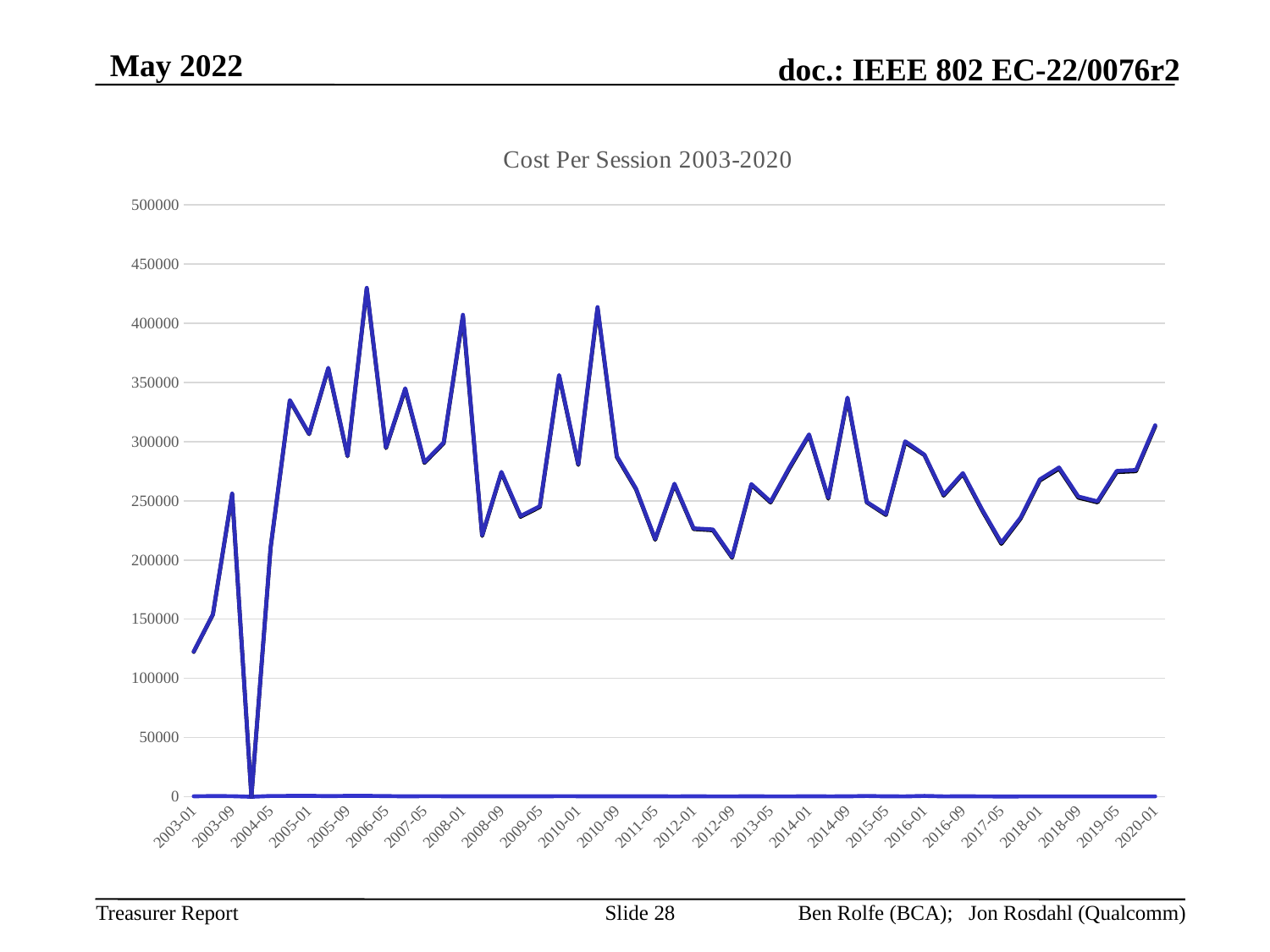
What is the maximum value shown on the vertical axis? 500000 What type of chart is shown on the slide? line chart Is the value for 2003-01 greater or less than 100000? greater Does the line rise or fall between 2003-01 and 2003-09? rise Is the value for 2003-01 greater or less than 150000? less Is the highest value on the line greater or less than 450000? less What is the title of the chart? Cost Per Session 2003-2020 What is the lowest value the line reaches on the chart? 0 Which is larger, the value for 2003-01 or the value for 2020-01? 2020-01